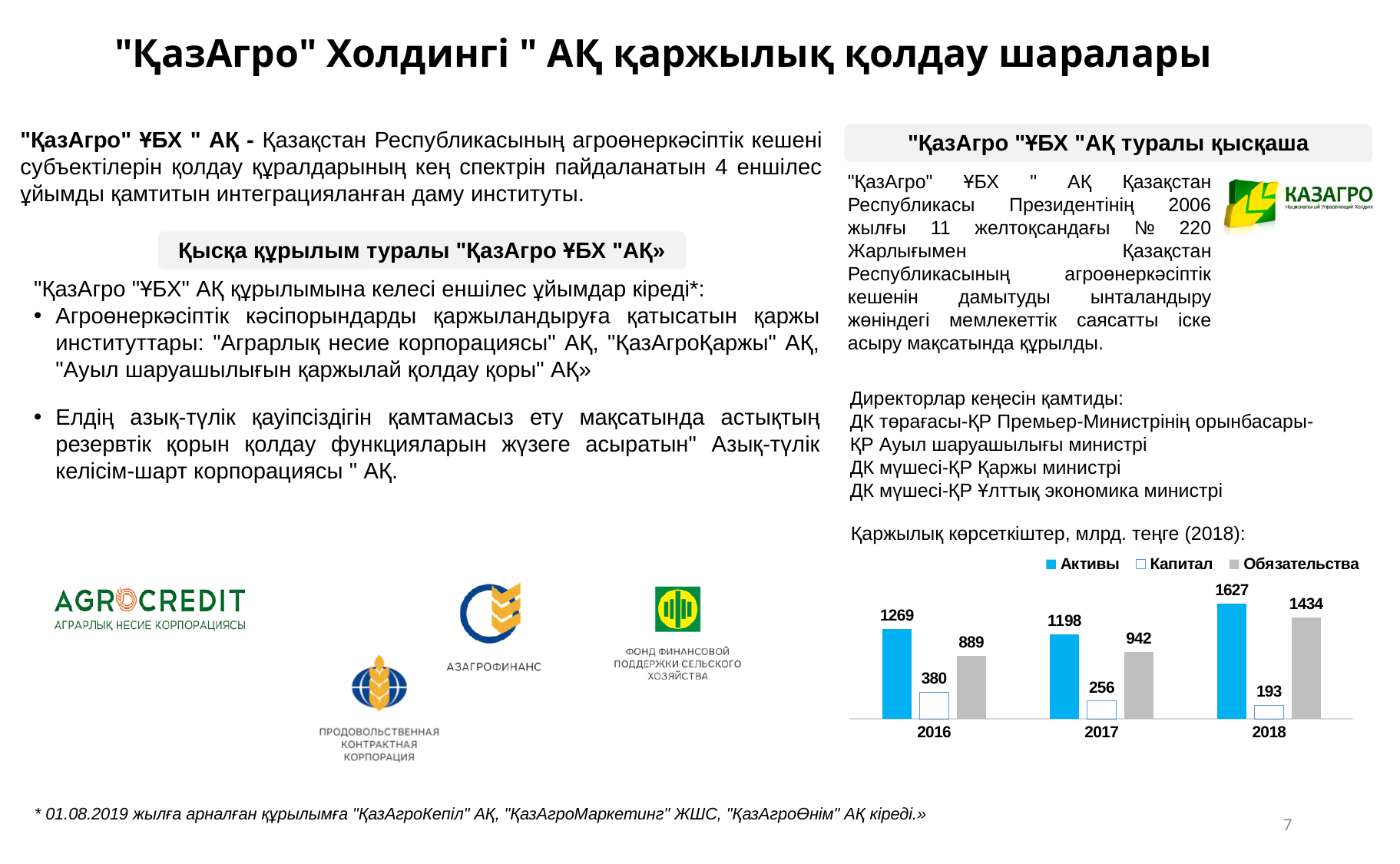
Which is larger: Активы in 2016 or Активы in 2017? Активы in 2016 Which series in the chart is shown in blue? Активы What is the value of Активы for 2018? 1627 What is the value of Капитал for 2016? 380 In which year is Капитал lowest? 2018 How many years are shown on the x axis of the chart? 3 What is the difference between Обязательства in 2018 and in 2016? 545 How many series does the chart legend list? 3 In which year is Активы highest? 2018 What is the value of Обязательства for 2017? 942 Does Капитал rise or fall from 2016 to 2018? fall What kind of chart is shown on the slide? bar chart